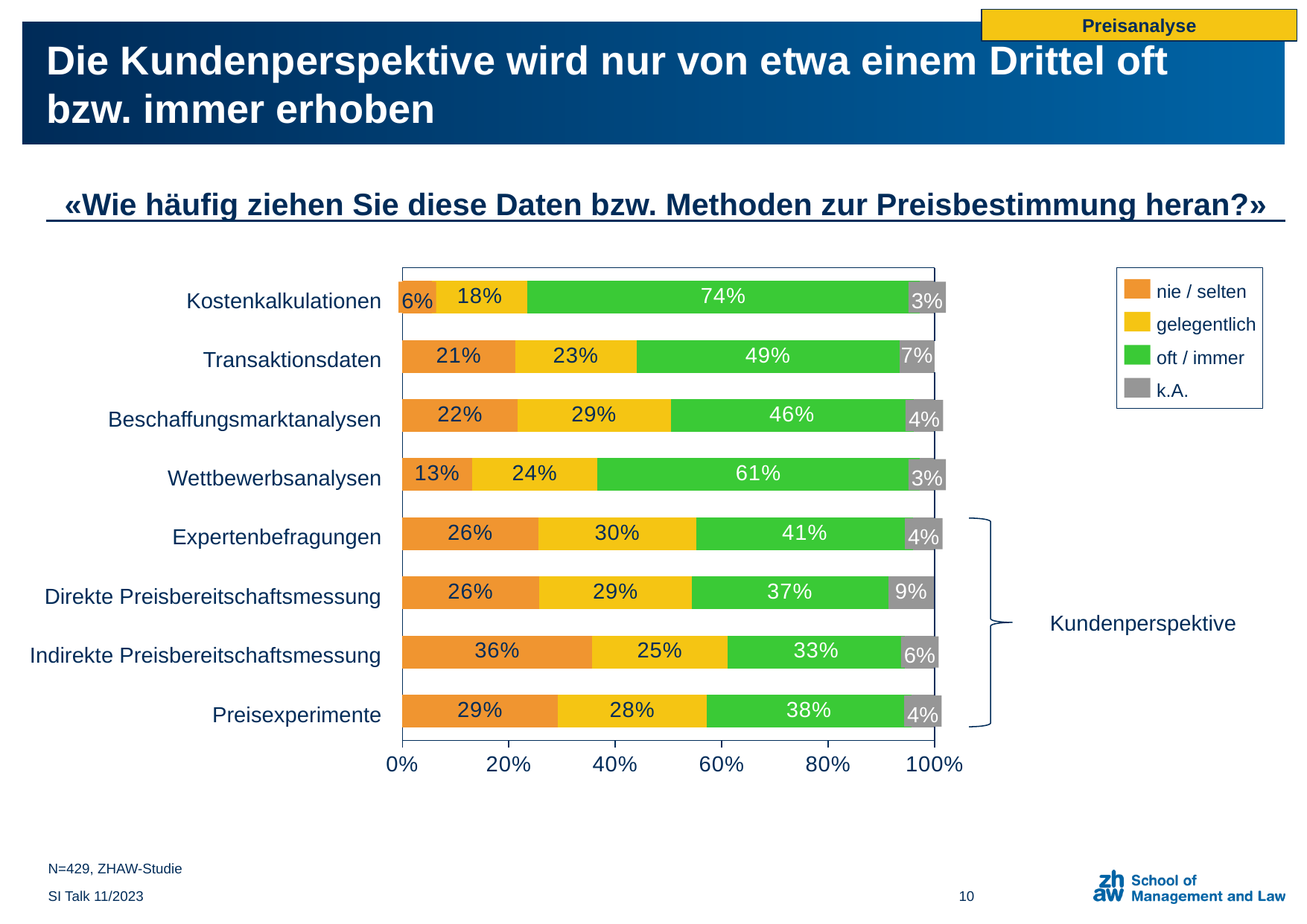
What is the 'k.A.' value for Direkte Preisbereitschaftsmessung? 9% Which category has the highest 'oft / immer' value? Kostenkalkulationen Which colour represents 'k.A.' in the chart? Grey What is the 'oft / immer' value for Kostenkalkulationen? 74% How many categories are shown on the y axis of the chart? 8 What is the 'nie / selten' value for Indirekte Preisbereitschaftsmessung? 36% How many series does the legend list? 4 What is the 'gelegentlich' value for Expertenbefragungen? 30% What kind of chart is shown on the slide? Stacked bar chart Which category has the lowest 'nie / selten' value? Kostenkalkulationen Which is larger: the 'gelegentlich' value for Beschaffungsmarktanalysen or for Transaktionsdaten? Beschaffungsmarktanalysen What is the difference between the 'oft / immer' values for Wettbewerbsanalysen and Preisexperimente? 23%